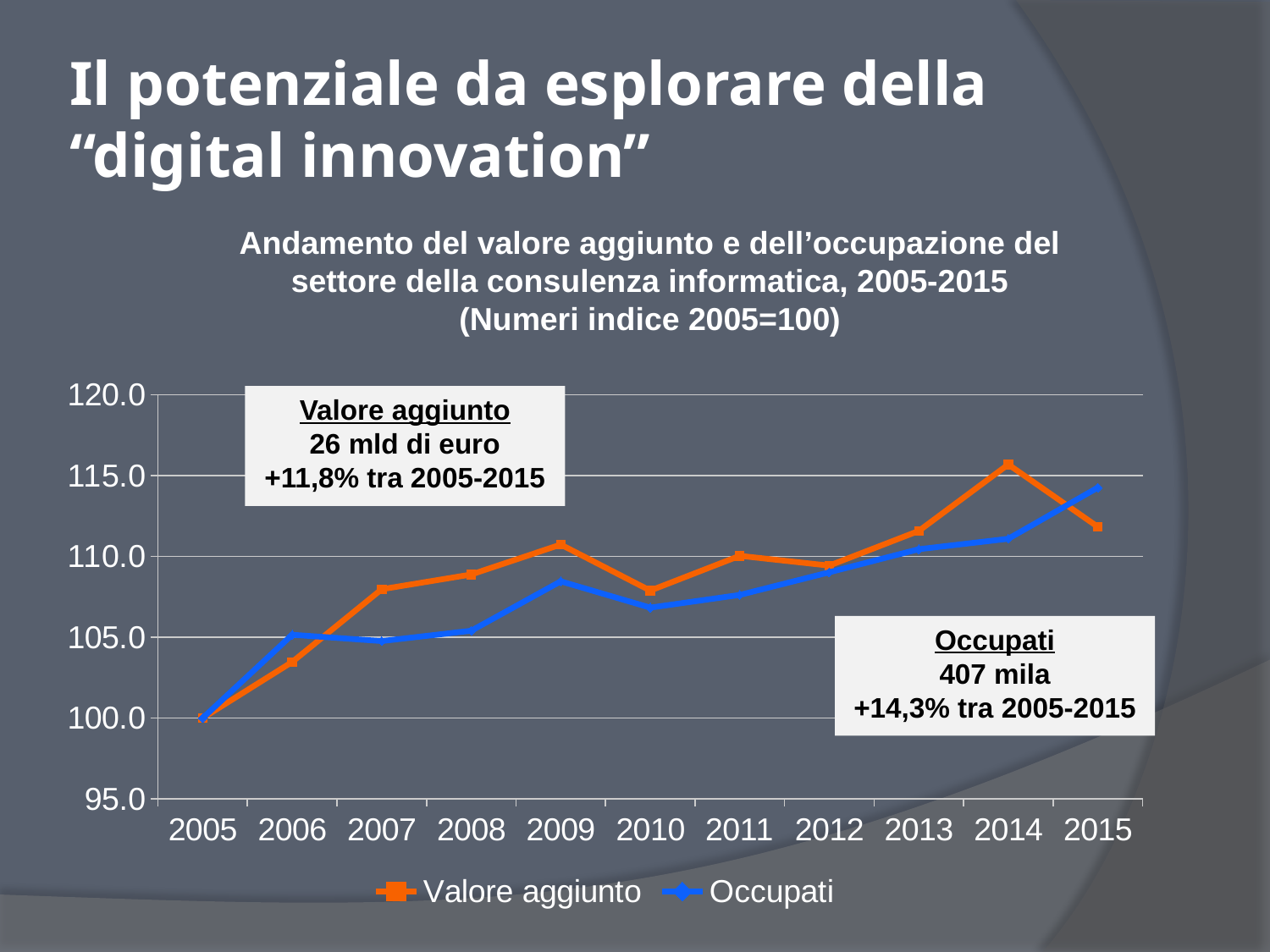
In which year does the Valore aggiunto series reach its highest value? 2014 In which year does the Occupati series reach its highest value? 2015 Is the value for Occupati in 2009 greater or less than 110.0? less How many years are plotted along the x axis? 11 How many series does the legend list? 2 According to the text box on the chart, what was the percentage change in Occupati between 2005 and 2015? +14,3% In 2014, which series has the higher value, Valore aggiunto or Occupati? Valore aggiunto Is the value for Valore aggiunto in 2006 greater or less than 105.0? less In 2015, which series has the higher value, Valore aggiunto or Occupati? Occupati Is the value for Valore aggiunto in 2010 greater or less than 110.0? less What kind of chart is shown on the slide? line chart